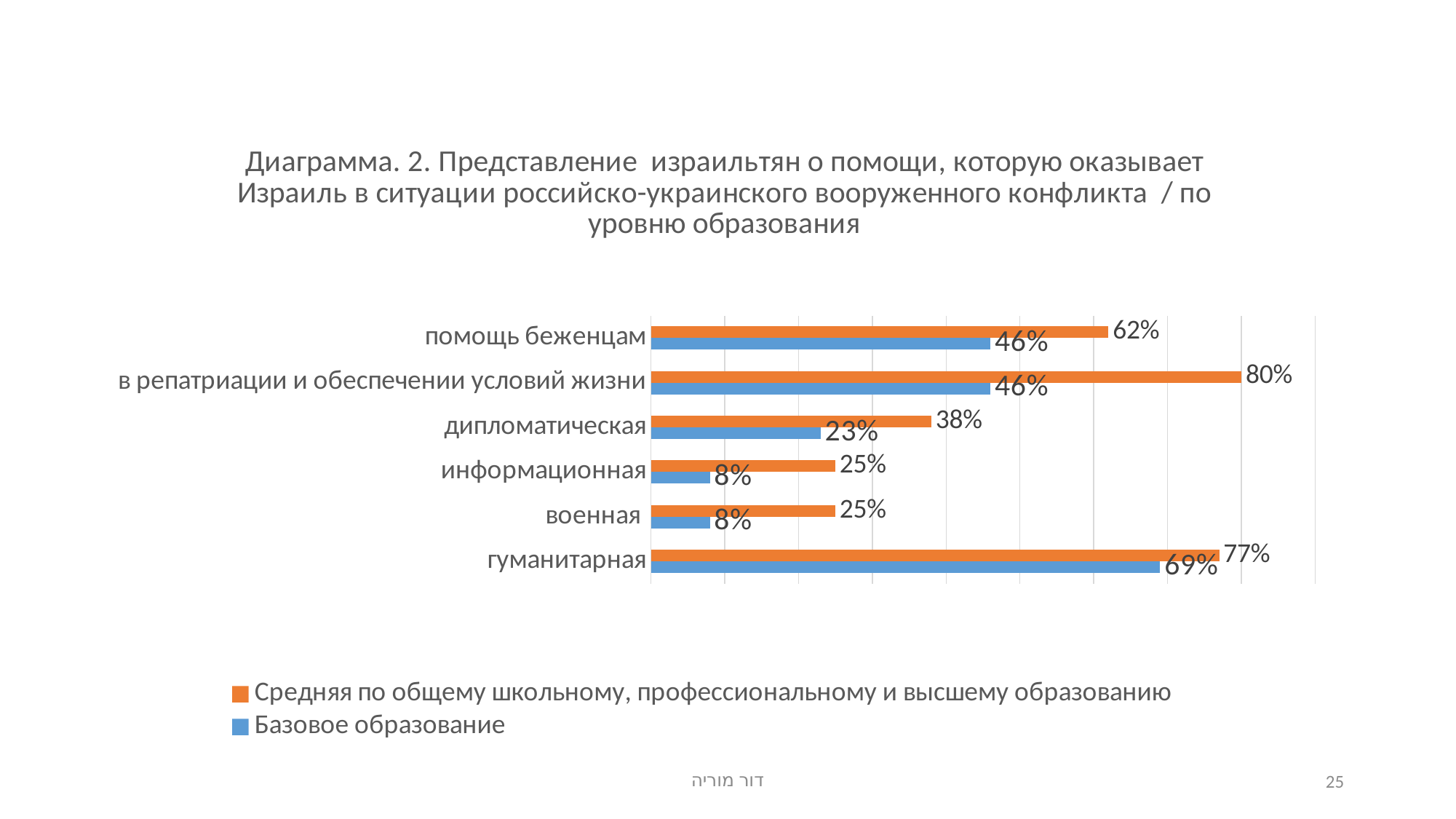
How many series does the legend list? 2 What is the difference between the two series in the category 'в репатриации и обеспечении условий жизни'? 34% Which colour represents 'Базовое образование' in the chart? Blue What is the value for 'Базовое образование' in the category 'дипломатическая'? 23% Which category has the highest value for 'Базовое образование'? гуманитарная What is the value for 'Базовое образование' in the category 'гуманитарная'? 69% In the category 'помощь беженцам', which series has the larger value? Средняя по общему школьному, профессиональному и высшему образованию How many categories are shown on the chart? 6 Which category has the lowest value for 'Средняя по общему школьному, профессиональному и высшему образованию'? военная and информационная (both 25%) What kind of chart is shown on the slide? Bar chart Which category has the highest value for 'Средняя по общему школьному, профессиональному и высшему образованию'? в репатриации и обеспечении условий жизни What is the value for 'Средняя по общему школьному, профессиональному и высшему образованию' in the category 'в репатриации и обеспечении условий жизни'? 80%